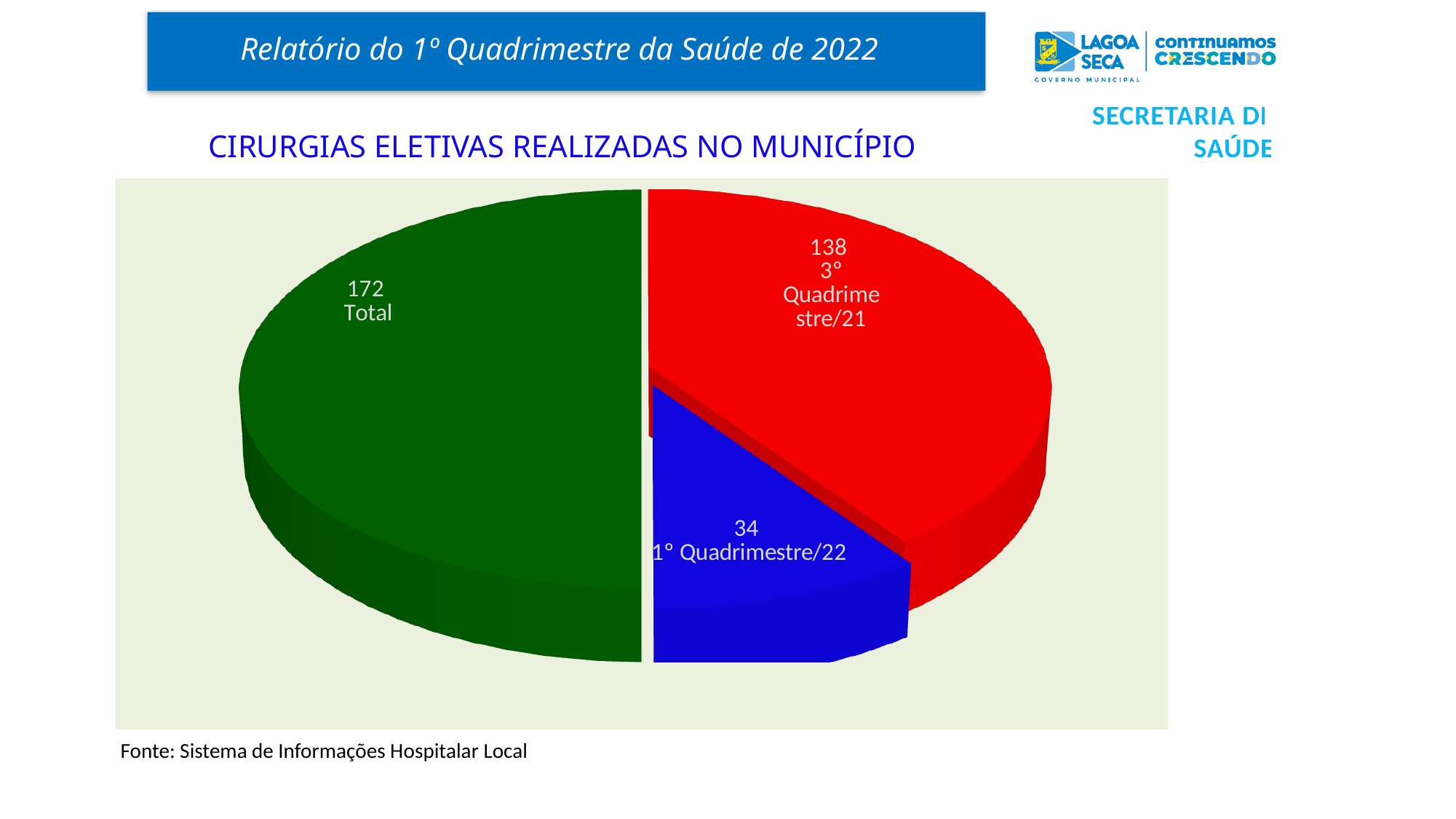
What is the value for 3° Quadrimestre/21? 138 What is the title of the chart? CIRURGIAS ELETIVAS REALIZADAS NO MUNICÍPIO What type of chart is shown on the slide? Pie chart Which is larger, the value for 3° Quadrimestre/21 or for 1° Quadrimestre/22? 3° Quadrimestre/21 What is the difference between the values for 3° Quadrimestre/21 and 1° Quadrimestre/22? 104 What colour is the slice for 1° Quadrimestre/22? Blue What is the value of the slice labelled Total? 172 What is the value for 1° Quadrimestre/22? 34 What is the difference between the Total slice and the 3° Quadrimestre/21 slice? 34 Which slice of the pie has the smallest value? 1° Quadrimestre/22 How many slices does the pie chart have? 3 Which slice of the pie has the largest value? Total